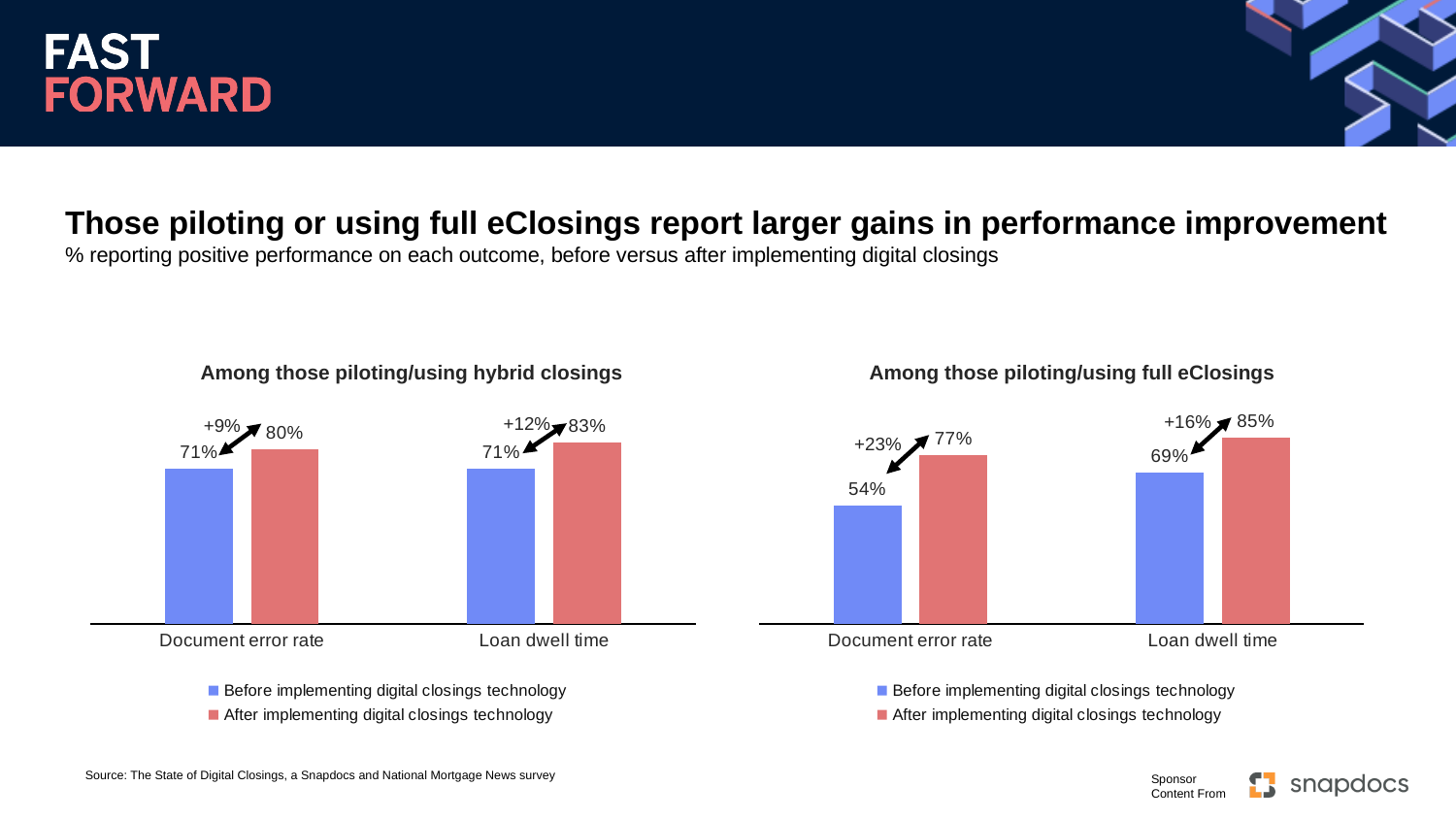
What kind of chart is the 'Among those piloting/using full eClosings' chart? Bar chart In the 'Among those piloting/using full eClosings' chart, what is the value for Document error rate before implementing digital closings technology? 54% In the 'Among those piloting/using full eClosings' chart, which category has the lowest value before implementing digital closings technology? Document error rate In the 'Among those piloting/using full eClosings' chart, what is the difference between the after and before values for Document error rate? 23% In the 'Among those piloting/using hybrid closings' chart, what is the value for Loan dwell time after implementing digital closings technology? 83% How many categories are shown on the x axis of the 'Among those piloting/using full eClosings' chart? 2 In the 'Among those piloting/using hybrid closings' chart, what is the difference between the after and before values for Loan dwell time? 12% How many series does the legend of the 'Among those piloting/using hybrid closings' chart list? 2 In the 'Among those piloting/using hybrid closings' chart, which is larger: the after value for Document error rate or the after value for Loan dwell time? Loan dwell time In the 'Among those piloting/using hybrid closings' chart, which colour represents 'After implementing digital closings technology'? Red In the 'Among those piloting/using full eClosings' chart, what is the value for Loan dwell time after implementing digital closings technology? 85% In the 'Among those piloting/using hybrid closings' chart, what is the value for Document error rate before implementing digital closings technology? 71%